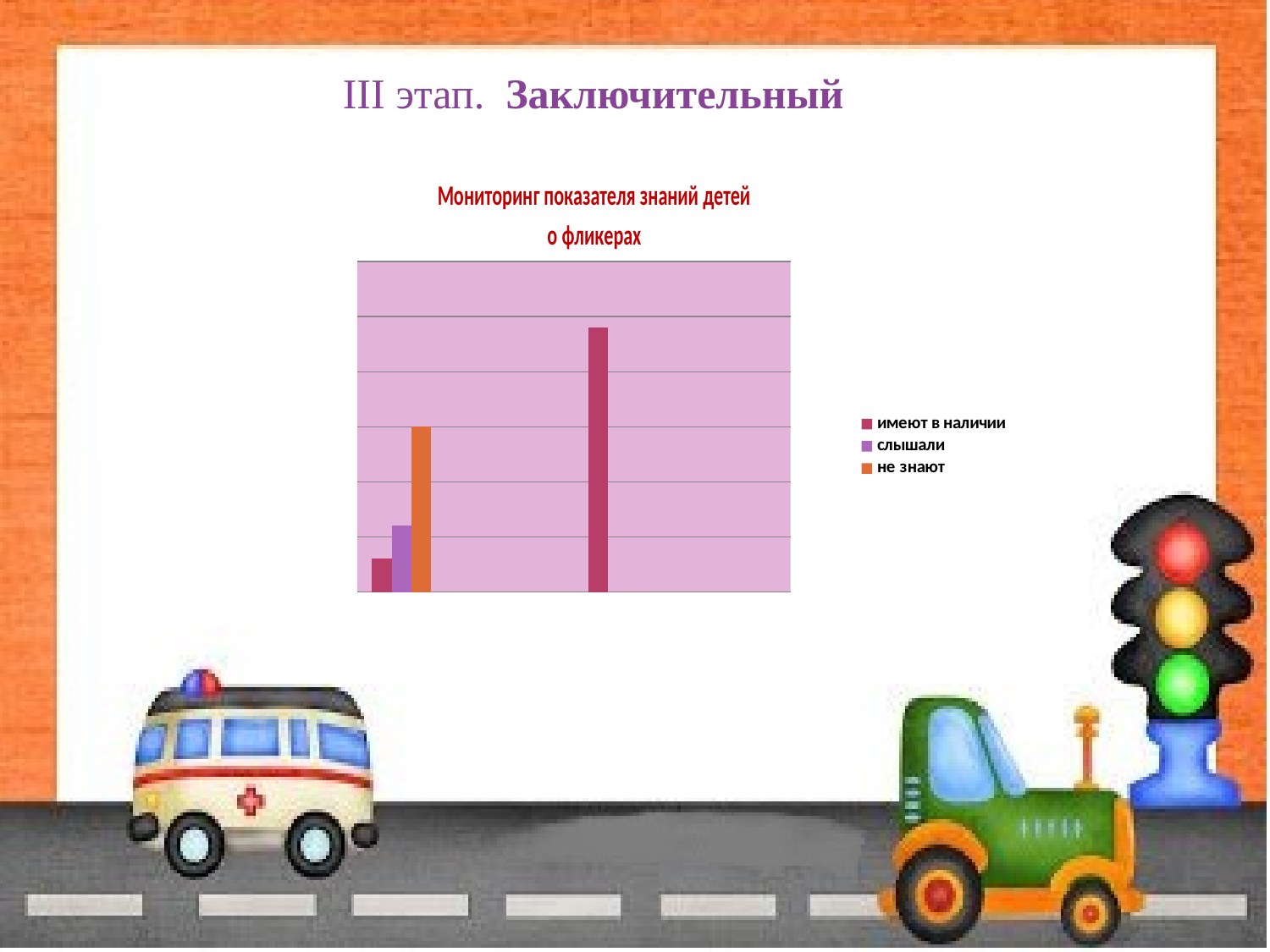
In the left group of bars, which series has the shortest bar? имеют в наличии Which legend entry is shown in orange? не знают In the left group of bars, which series has the tallest bar? не знают In the left group of bars, which is larger: the bar for 'слышали' or the bar for 'не знают'? не знают Which series has the tallest bar in the chart? имеют в наличии How many series does the legend list? 3 How many bars are plotted in the chart in total? 4 What is the title of the chart? Мониторинг показателя знаний детей о фликерах Which series is the only one plotted in the right group of bars? имеют в наличии What kind of chart is shown on the slide? bar chart How many groups of bars are there along the x axis? 2 Does the bar for 'имеют в наличии' rise or fall from the left group to the right group? rise